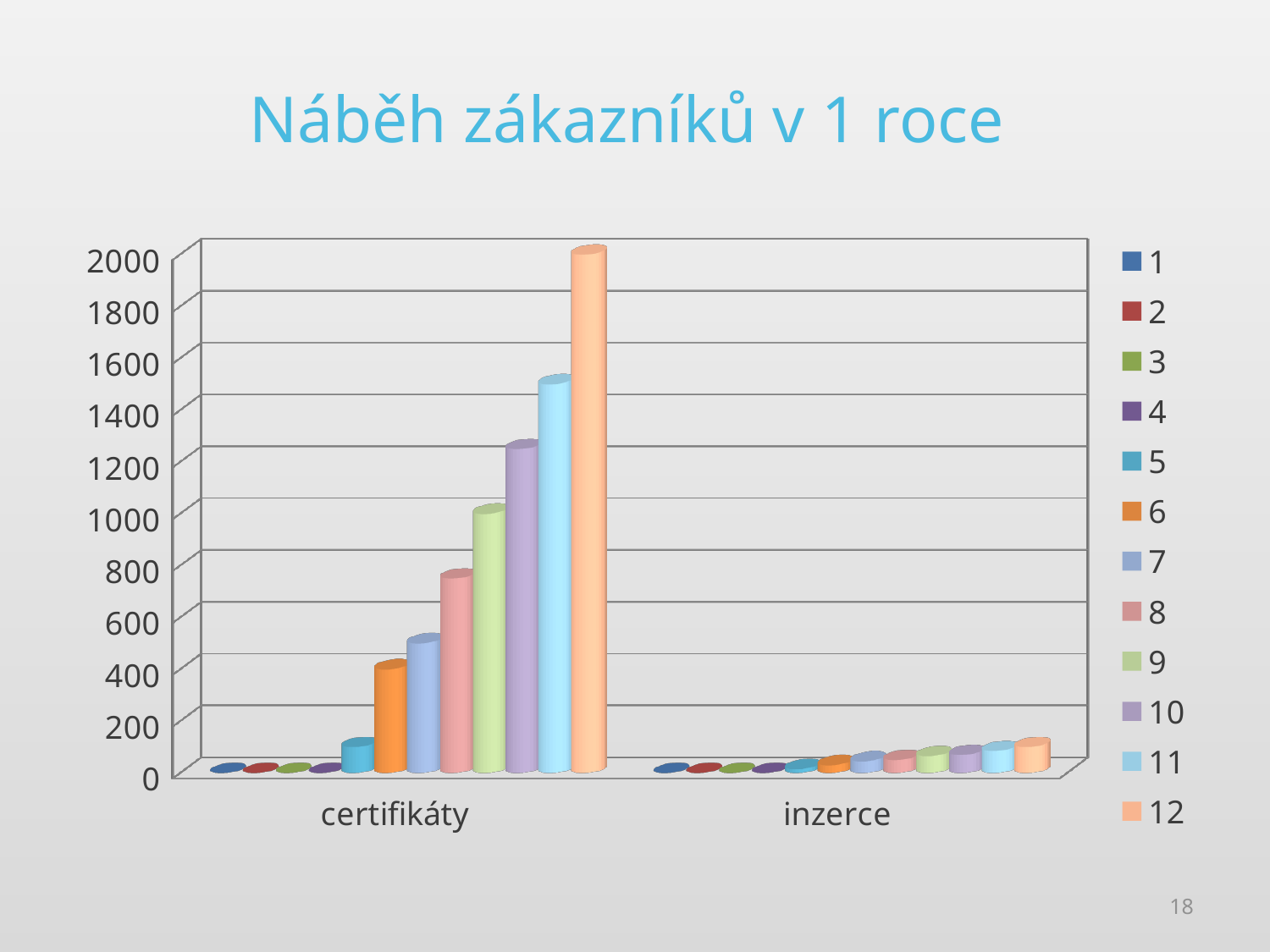
What kind of chart is shown on the slide? bar chart Is the value of series 12 for inzerce greater or less than 200? less Which category has the higher values overall, certifikáty or inzerce? certifikáty Is the value of series 12 for certifikáty greater or less than 1800? greater Is the value of series 6 for certifikáty greater or less than 600? less How many categories are shown on the x axis? 2 Which is larger: the value of series 12 for certifikáty or for inzerce? certifikáty Which series has the highest value in the certifikáty category? 12 What is the title of the chart? Náběh zákazníků v 1 roce How many series does the legend list? 12 Do the values for certifikáty rise or fall from series 1 to series 12? rise